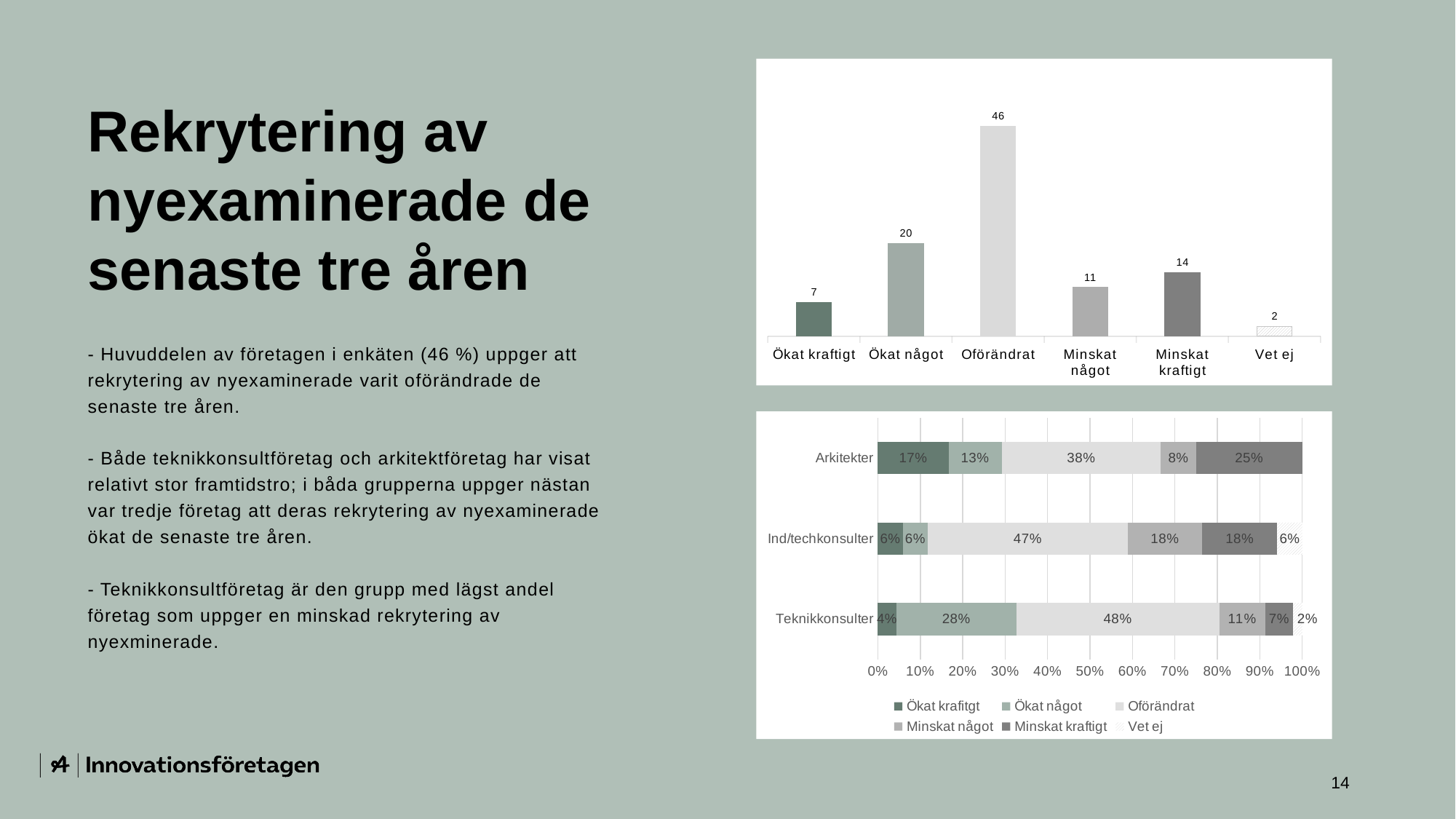
In the top chart, what is the difference between the values for Ökat något and Ökat kraftigt? 13 In the bottom chart, which group has the larger Ökat något share, Teknikkonsulter or Arkitekter? Teknikkonsulter How many series does the legend of the bottom chart list? 6 What kind of chart is the top chart? Bar chart In the top chart, how many categories are shown on the x axis? 6 In the bottom chart, what is the Minskat kraftigt share for Arkitekter? 25% In the bottom chart, what is the difference between the Minskat något shares for Ind/techkonsulter and Teknikkonsulter? 7% In the bottom chart, what is the Oförändrat share for Ind/techkonsulter? 47% In the top chart, what is the value for Oförändrat? 46 In the top chart, which category has the lowest value? Vet ej In the top chart, which category has the highest value? Oförändrat In the top chart, what is the value for Minskat kraftigt? 14